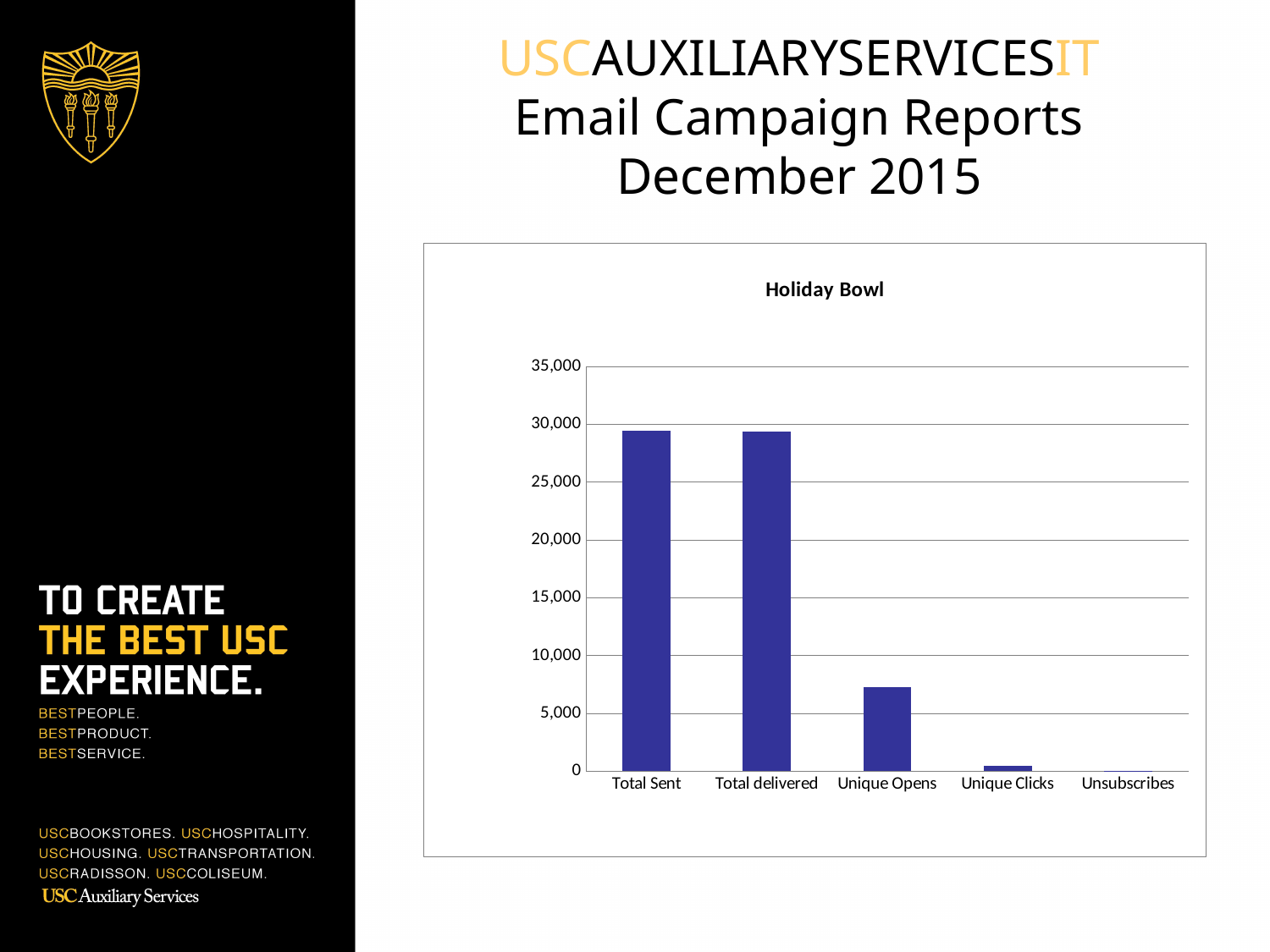
Is the value for Total Sent greater or less than 25,000? greater What is the title of the chart? Holiday Bowl Do the values generally rise or fall moving from left to right along the x axis? fall Is the value for Unique Clicks greater or less than 5,000? less Which category has the lowest value in the chart? Unsubscribes What colour are the bars in the chart? blue Is the value for Unique Opens greater or less than 10,000? less Which is larger, the value for Total Sent or the value for Unique Opens? Total Sent What kind of chart is shown on the slide? bar chart How many categories are shown on the x axis of the chart? 5